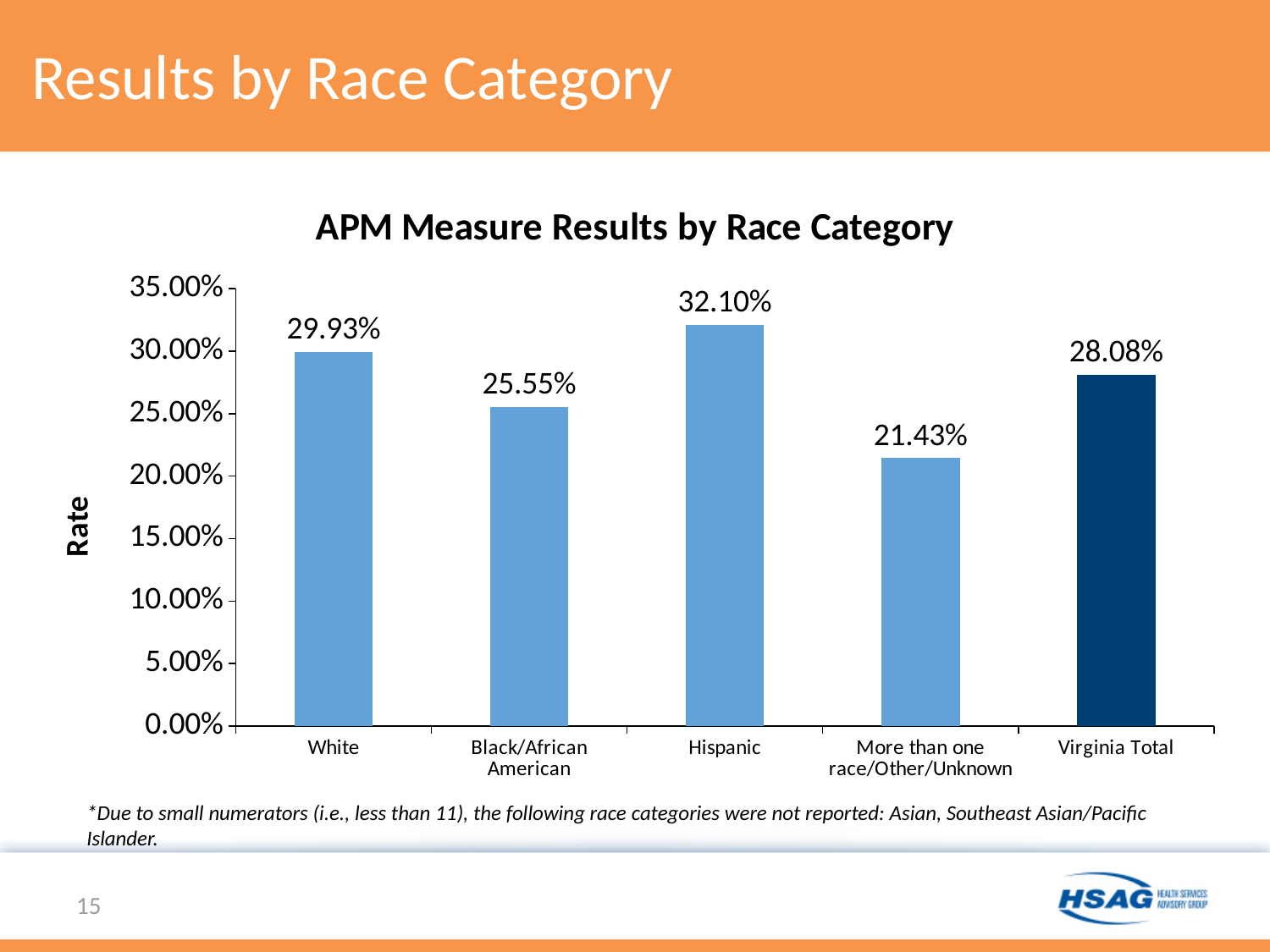
What is the rate shown for Virginia Total? 28.08% What is the APM measure rate for Hispanic? 32.10% Which race category has the highest rate? Hispanic Is the rate for Black/African American greater or less than 30.00%? less What is the difference between the Virginia Total rate and the rate for More than one race/Other/Unknown? 6.65% Which category has the lowest rate? More than one race/Other/Unknown How many categories are shown on the x axis? 5 What is the title of the chart? APM Measure Results by Race Category What kind of chart is shown on the slide? Bar chart What is the difference between the rates for Hispanic and White? 2.17% What is the APM measure rate for Black/African American? 25.55% Which is larger, the rate for White or the rate for Virginia Total? White